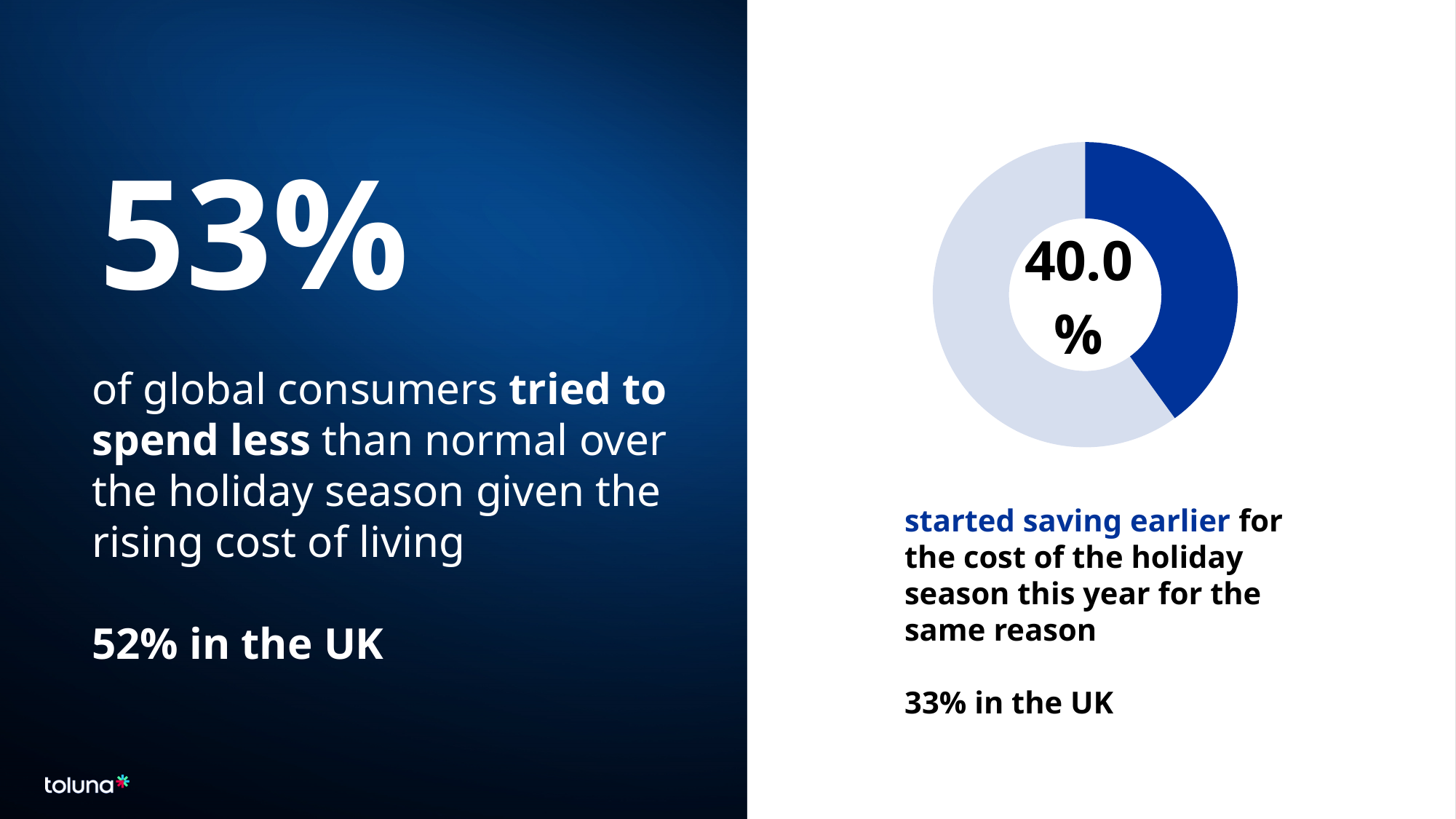
What colour is the slice of the donut chart that represents the 40.0% value? Dark blue Which slice of the donut chart is larger, the dark blue slice or the light grey slice? The light grey slice What share of the donut chart does the dark blue slice represent? 40.0% What share of the donut chart does the light grey slice represent? 60.0% What value is printed in the centre of the donut chart? 40.0% How many slices does the donut chart have? 2 Is the value shown in the donut chart greater or less than 25%? greater According to the text beneath the donut chart, what does the 40.0% value represent? Consumers who started saving earlier for the cost of the holiday season this year What kind of chart is shown on the right side of the slide? Pie (donut) chart Is the value shown in the donut chart greater or less than 50%? less